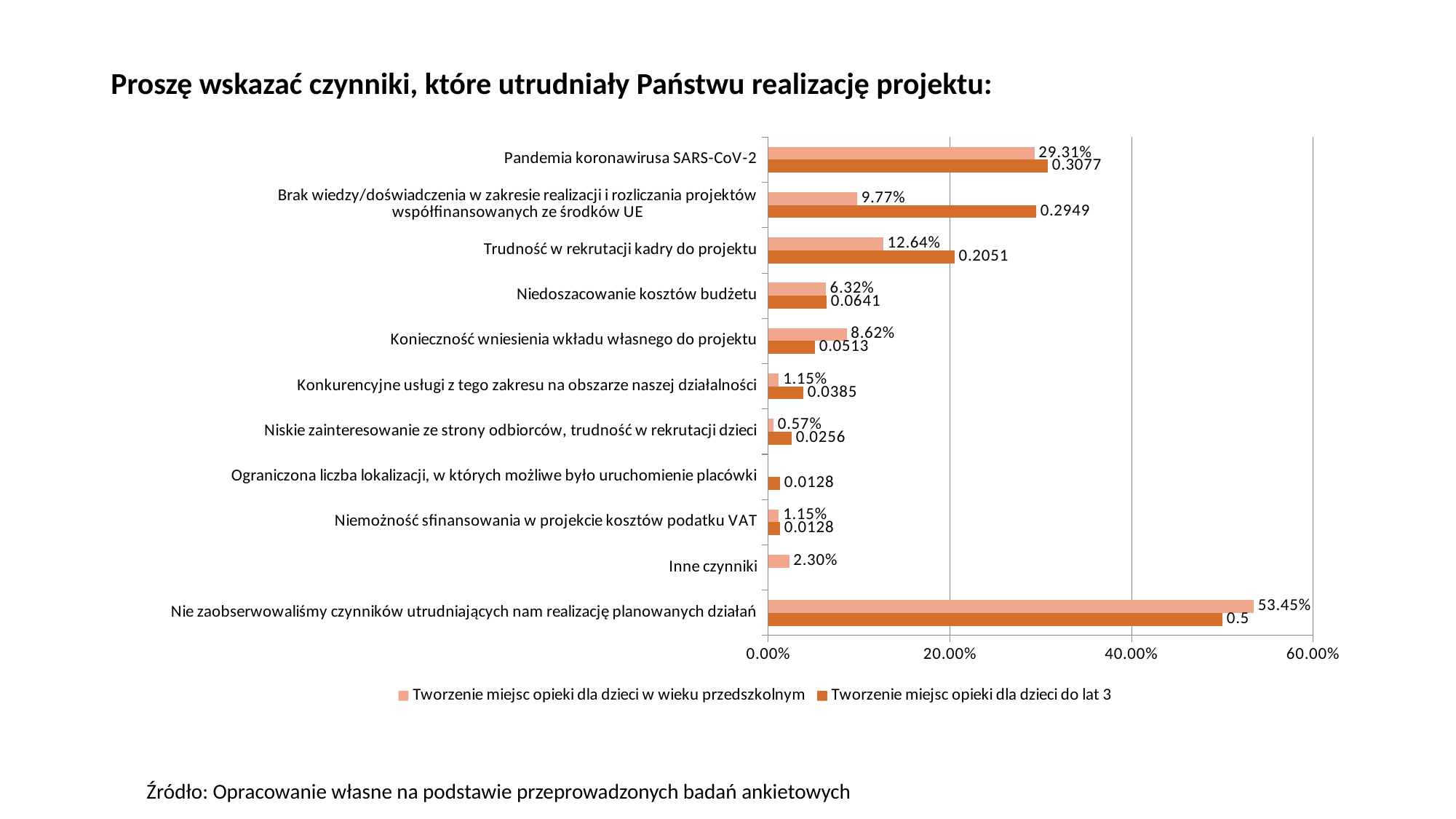
What type of chart is shown on the slide? bar chart In the series 'Tworzenie miejsc opieki dla dzieci w wieku przedszkolnym', which is larger: 'Brak wiedzy/doświadczenia w zakresie realizacji i rozliczania projektów współfinansowanych ze środków UE' or 'Trudność w rekrutacji kadry do projektu'? Trudność w rekrutacji kadry do projektu What is the value for 'Inne czynniki' in the series 'Tworzenie miejsc opieki dla dzieci w wieku przedszkolnym'? 2.30% What is the difference between the values for 'Nie zaobserwowaliśmy czynników utrudniających nam realizację planowanych działań' and 'Pandemia koronawirusa SARS-CoV-2' in the series 'Tworzenie miejsc opieki dla dzieci w wieku przedszkolnym'? 24.14% Is the value for 'Nie zaobserwowaliśmy czynników utrudniających nam realizację planowanych działań' in the series 'Tworzenie miejsc opieki dla dzieci w wieku przedszkolnym' greater or less than 40.00%? greater What is the value for 'Trudność w rekrutacji kadry do projektu' in the series 'Tworzenie miejsc opieki dla dzieci do lat 3'? 0.2051 Which category has the highest value in the series 'Tworzenie miejsc opieki dla dzieci do lat 3'? Nie zaobserwowaliśmy czynników utrudniających nam realizację planowanych działań What is the title of the chart? Proszę wskazać czynniki, które utrudniały Państwu realizację projektu: What is the value for 'Pandemia koronawirusa SARS-CoV-2' in the series 'Tworzenie miejsc opieki dla dzieci w wieku przedszkolnym'? 29.31% How many categories are shown on the vertical axis of the chart? 11 How many series does the legend list? 2 Which category has the lowest value in the series 'Tworzenie miejsc opieki dla dzieci w wieku przedszkolnym'? Niskie zainteresowanie ze strony odbiorców, trudność w rekrutacji dzieci